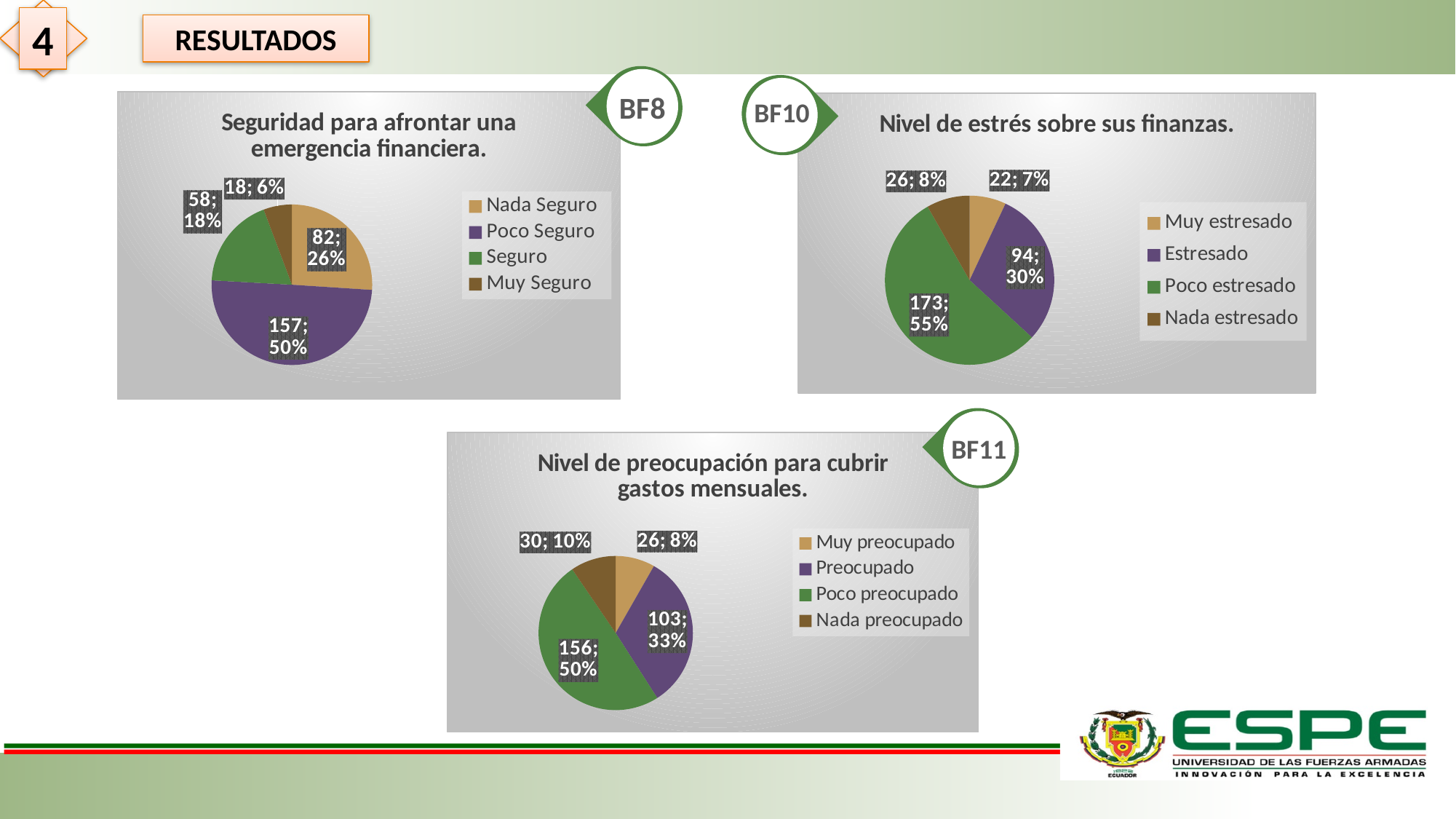
In the chart 'Nivel de preocupación para cubrir gastos mensuales.', what is the count for Preocupado? 103 In the chart 'Nivel de preocupación para cubrir gastos mensuales.', what share of the pie is Poco preocupado? 50% In the chart 'Seguridad para afrontar una emergencia financiera.', which category has the smallest slice? Muy Seguro In the chart 'Seguridad para afrontar una emergencia financiera.', what is the difference between the counts for Poco Seguro and Seguro? 99 In the chart 'Nivel de estrés sobre sus finanzas.', which category has the largest slice? Poco estresado In the chart 'Nivel de preocupación para cubrir gastos mensuales.', which is larger, Nada preocupado or Muy preocupado? Nada preocupado In the chart 'Seguridad para afrontar una emergencia financiera.', what is the count for Poco Seguro? 157 In the chart 'Seguridad para afrontar una emergencia financiera.', what share of the pie is Nada Seguro? 26% In the chart 'Nivel de estrés sobre sus finanzas.', what share of the pie is Estresado? 30% In the chart 'Nivel de estrés sobre sus finanzas.', what is the count for Poco estresado? 173 In the chart 'Nivel de estrés sobre sus finanzas.', how many categories does the legend list? 4 What type of chart is used for 'Nivel de preocupación para cubrir gastos mensuales.'? Pie chart